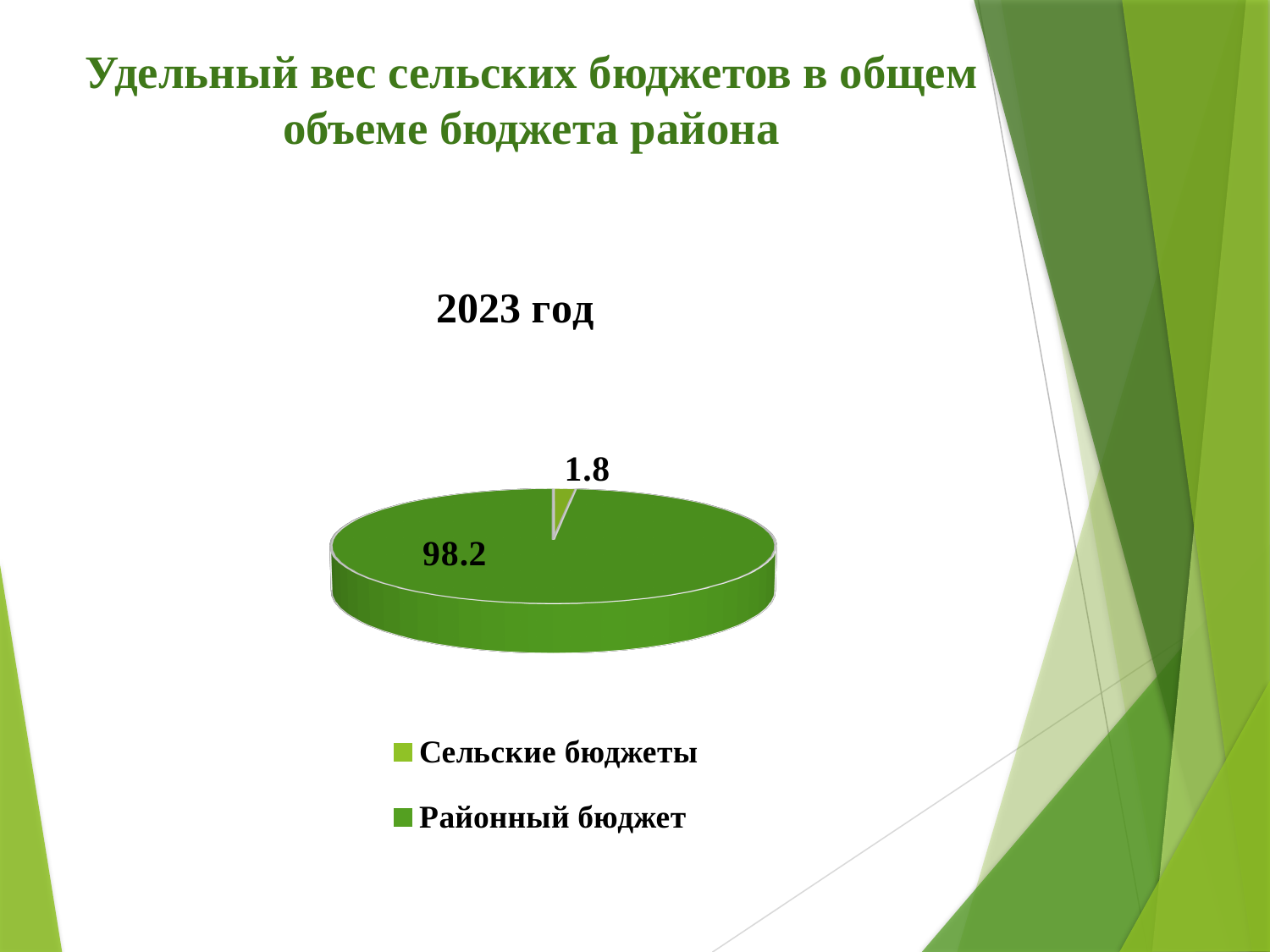
What is the value for Сельские бюджеты? 1.8 What kind of chart is shown on the slide? pie chart What is the difference between the values for Районный бюджет and Сельские бюджеты? 96.4 Which category has the smallest slice? Сельские бюджеты How many entries does the legend list? 2 Which is larger: Сельские бюджеты or Районный бюджет? Районный бюджет Which category has the largest slice? Районный бюджет Which legend entry is shown in the lighter green colour? Сельские бюджеты How many slices does the pie chart have? 2 What is the value for Районный бюджет? 98.2 What year is shown as the chart title? 2023 год